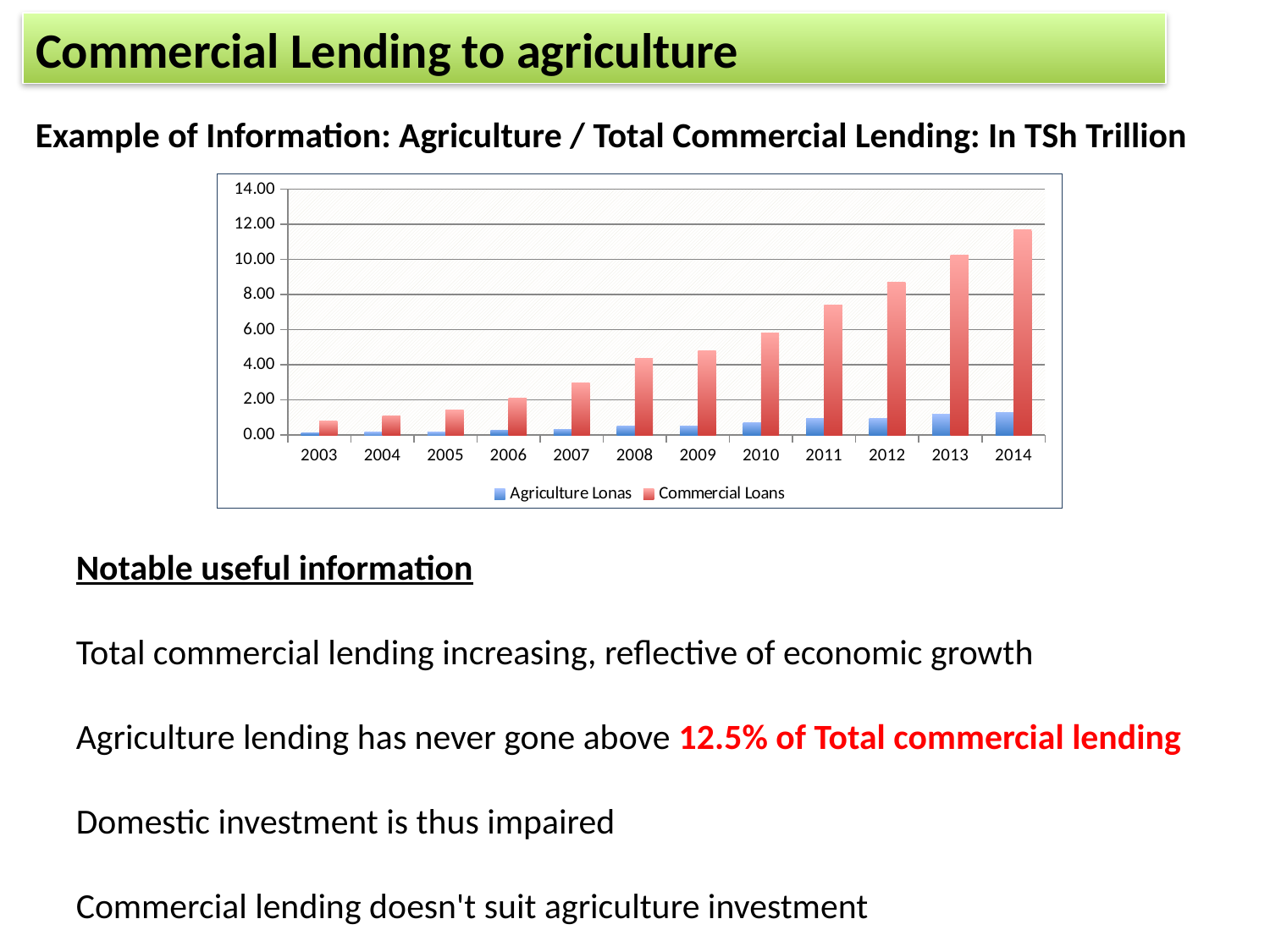
Is the value for Commercial Loans in 2014 greater or less than 10.00? greater Is the value for Agriculture Lonas in 2014 greater or less than 2.00? less What kind of chart is shown on the slide? Bar chart Is the value for Commercial Loans in 2007 greater or less than 4.00? less How many years are shown on the x axis of the chart? 12 In 2014, which series has the larger value, Agriculture Lonas or Commercial Loans? Commercial Loans Which year has the highest value for Commercial Loans? 2014 Which year has the lowest value for Commercial Loans? 2003 How many series does the legend list? 2 Do the Commercial Loans values rise or fall from 2003 to 2014? Rise